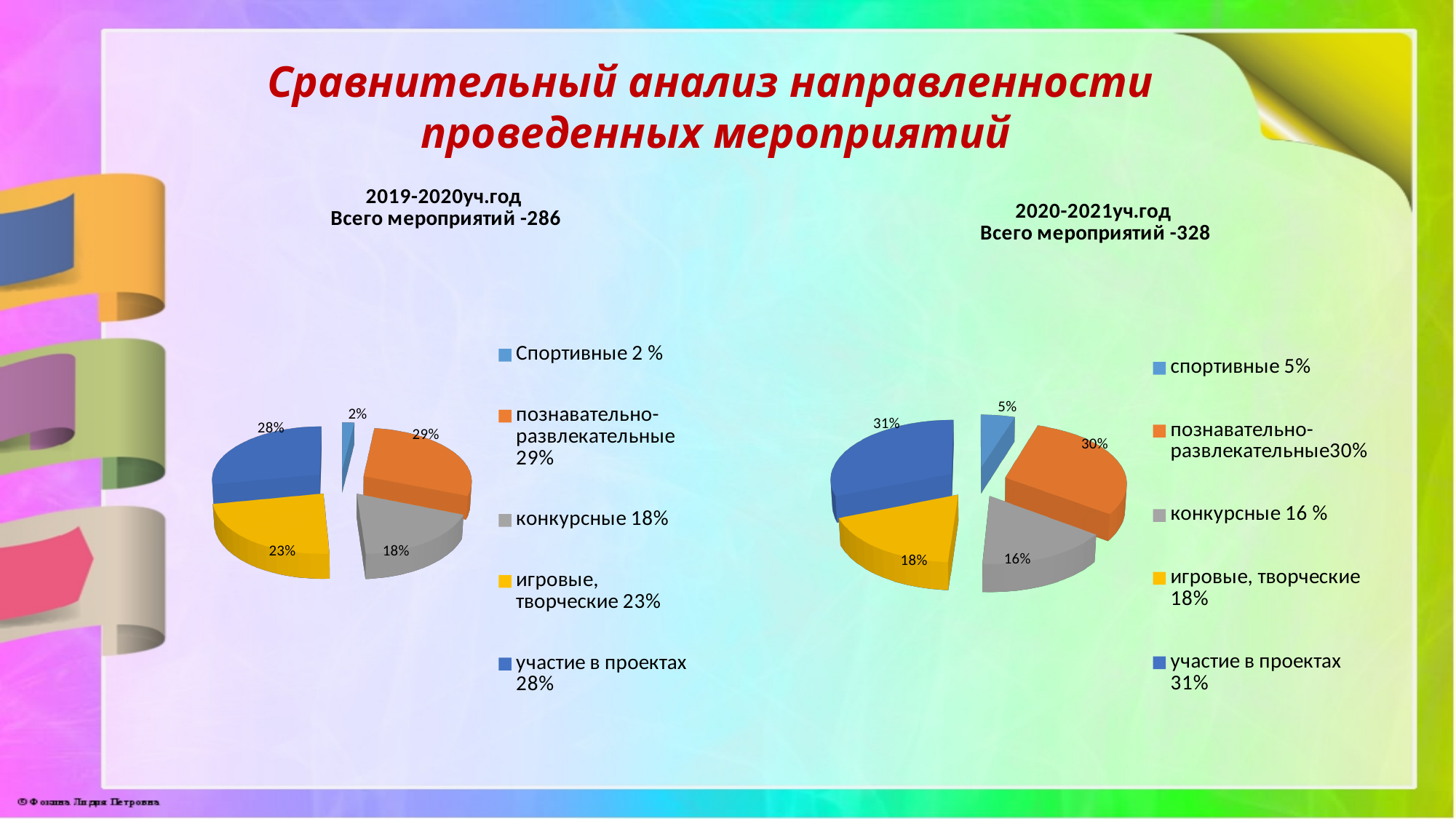
How many categories does the 2019-2020 chart show? 5 In the 2019-2020 chart, what is the difference between the 'игровые, творческие' share and the 'конкурсные' share? 5% Which is larger in the 2020-2021 chart: 'познавательно-развлекательные' or 'конкурсные'? познавательно-развлекательные What total number of events is stated for the 2020-2021 academic year? 328 What is the difference between the 'участие в проектах' share in the 2020-2021 chart and in the 2019-2020 chart? 3% What type of chart is used for the 2020-2021 data? pie chart In the 2019-2020 chart, what colour is the 'игровые, творческие' slice? yellow In the 2020-2021 chart, what share of events were 'участие в проектах'? 31% In the 2020-2021 chart, which category has the smallest share? спортивные In the 2019-2020 chart, what share of events were 'Спортивные'? 2% In the 2019-2020 chart, which category has the largest share? познавательно-развлекательные In the 2020-2021 chart, what share of events were 'конкурсные'? 16%